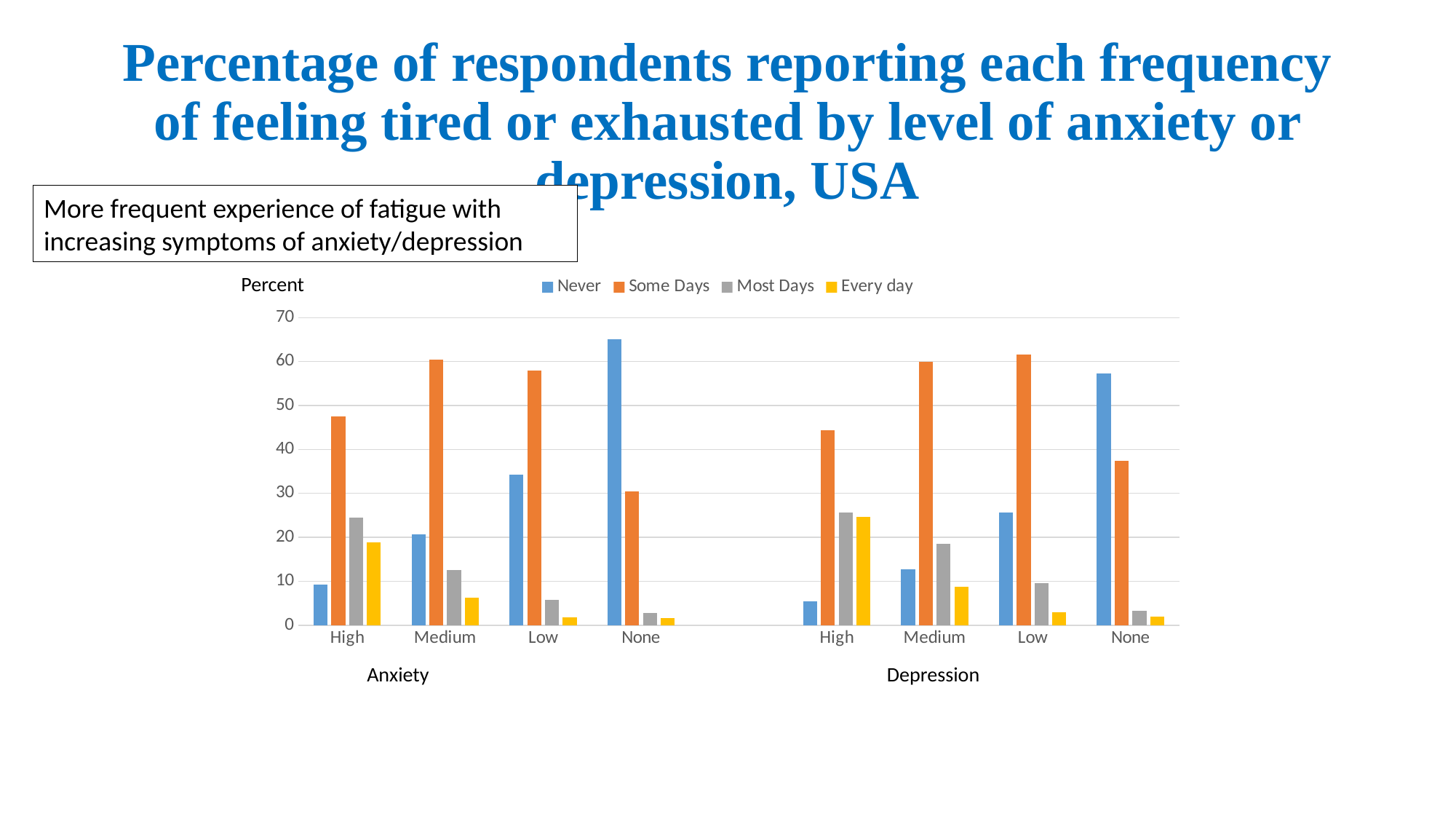
Is the Every day value for the Depression High category greater or less than 20? greater Do the Never values rise or fall going from High to None within the Anxiety group? Rise How many series does the legend list? 4 What kind of chart is shown on the slide? Bar chart Is the Never value for the Depression Medium category greater or less than 20? less How many categories are shown along the x axis? 8 Which is larger, the Some Days value for Anxiety Medium or for Anxiety High? Anxiety Medium Is the Never value for the Anxiety None category greater or less than 60? greater Which category has the lowest Never value? High (Depression) What label is shown on the vertical axis? Percent Which category has the highest Never value? None (Anxiety)